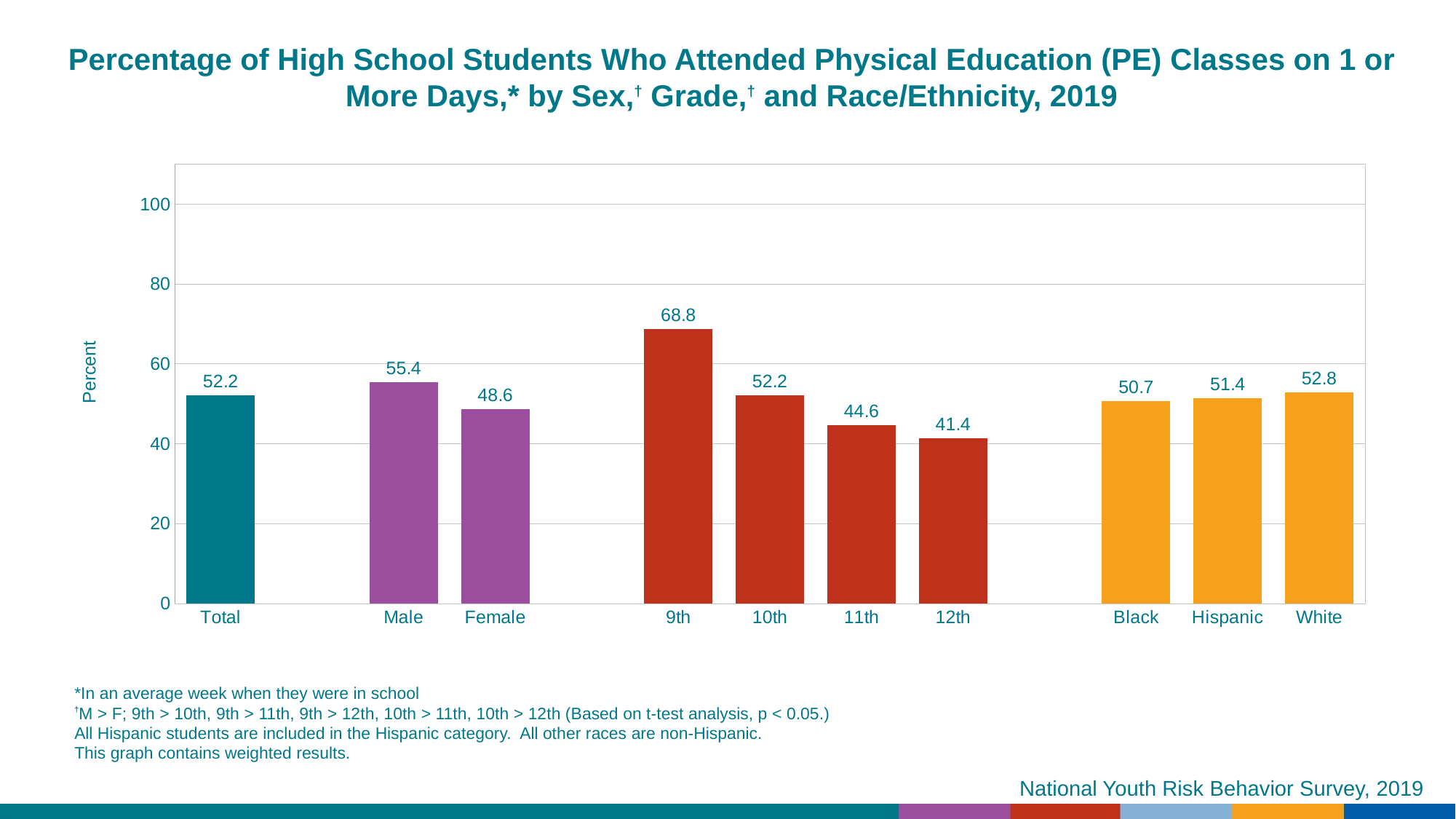
What is the difference between the values for Male and Female? 6.8 Which category has the lowest value? 12th What is the value for Male? 55.4 What is the value for 12th grade? 41.4 How many categories are shown on the x axis? 10 Do the values rise or fall from 9th grade to 12th grade? fall Is the value for 9th grade greater or less than 60? greater Which category has the highest value? 9th What is the value for Hispanic students? 51.4 Which is larger, the value for 11th grade or the value for Black students? Black What kind of chart is shown on the slide? bar chart What is the difference between the values for 9th and 10th grade? 16.6